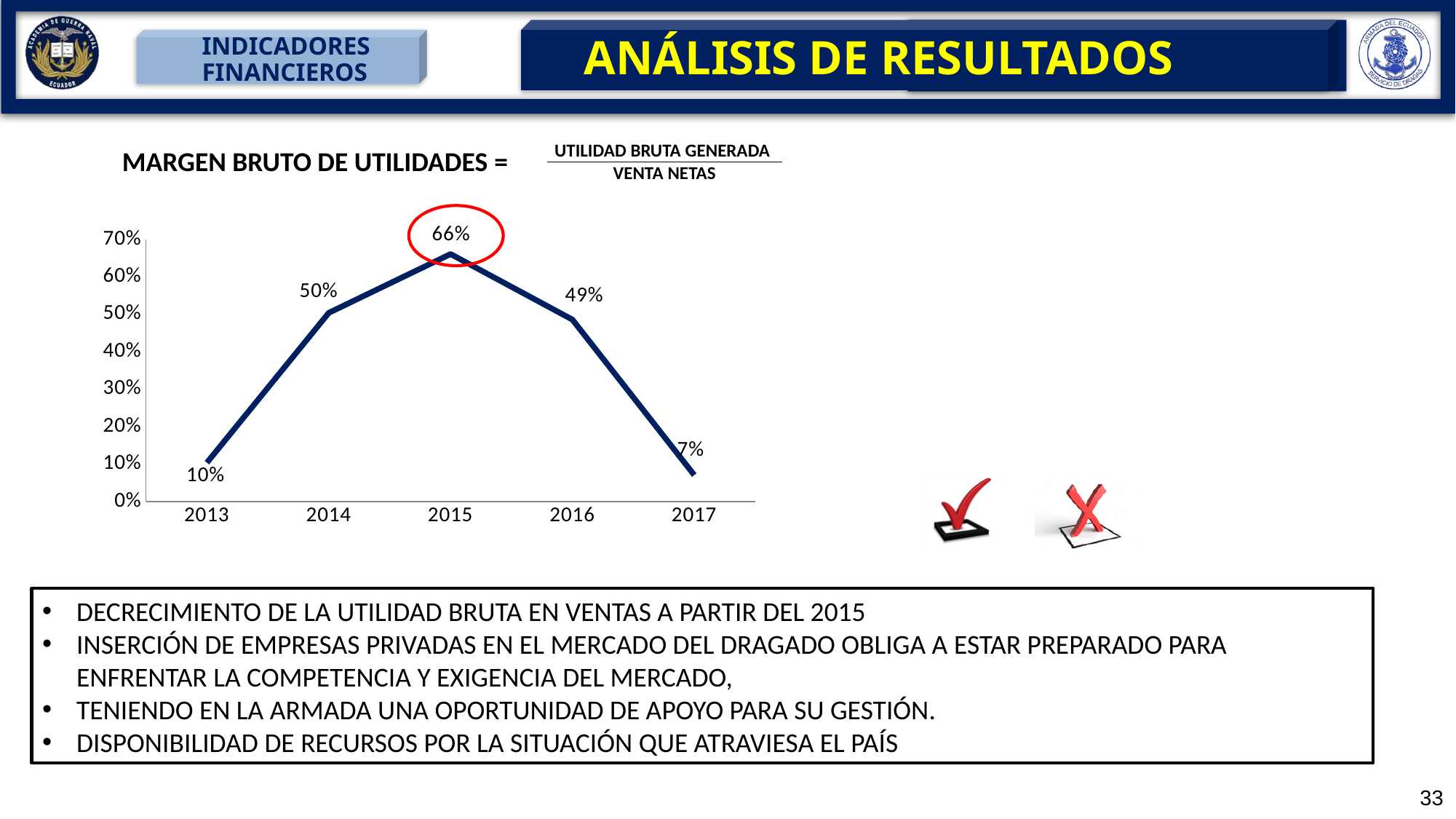
Is the value for 2016 greater or less than 40%? greater Which year has the lowest value on the chart? 2017 Do the values rise or fall from 2015 to 2017? fall Which year has a larger value, 2014 or 2016? 2014 What is the value shown for 2013? 10% How many years are plotted on the chart? 5 What is the difference between the values for 2014 and 2013? 40% What is the difference between the values for 2015 and 2016? 17% What kind of chart is shown on the slide? line chart What is the gross profit margin value shown for 2015? 66% What is the value shown for 2017? 7% Which year has the highest value on the chart? 2015